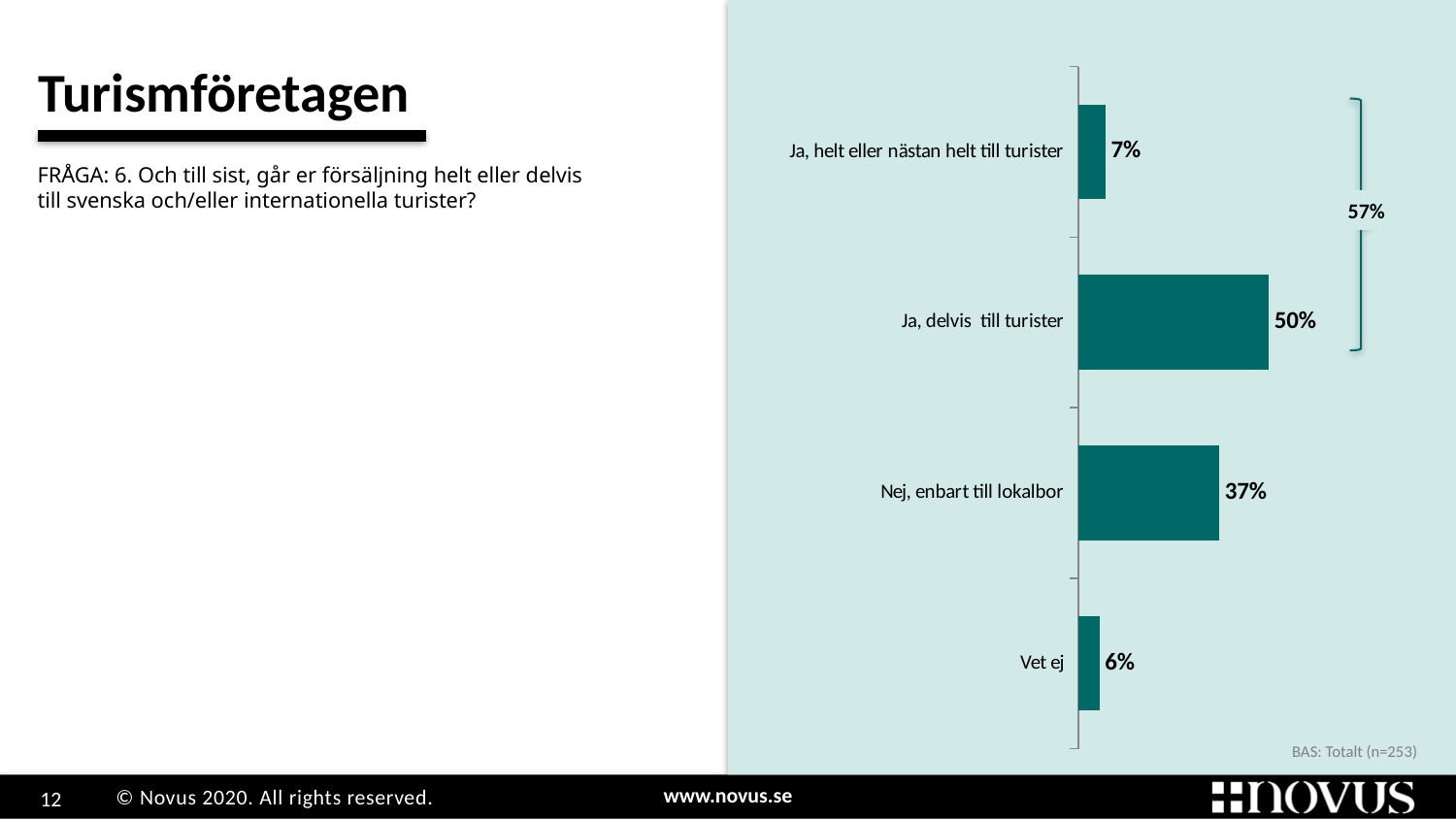
How many categories are shown in the chart? 4 What is the value for "Ja, delvis till turister"? 50% Which category has the lowest value? Vet ej What is the difference between "Ja, delvis till turister" and "Nej, enbart till lokalbor"? 13% What combined percentage is shown by the bracket grouping the two "Ja" categories? 57% Which category has the highest value? Ja, delvis till turister What is the value for "Vet ej"? 6% What is the value for "Nej, enbart till lokalbor"? 37% What is the value for "Ja, helt eller nästan helt till turister"? 7% Which is larger: "Ja, helt eller nästan helt till turister" or "Nej, enbart till lokalbor"? Nej, enbart till lokalbor What is the base (n) stated below the chart? Totalt (n=253) What kind of chart is shown on the slide? Bar chart